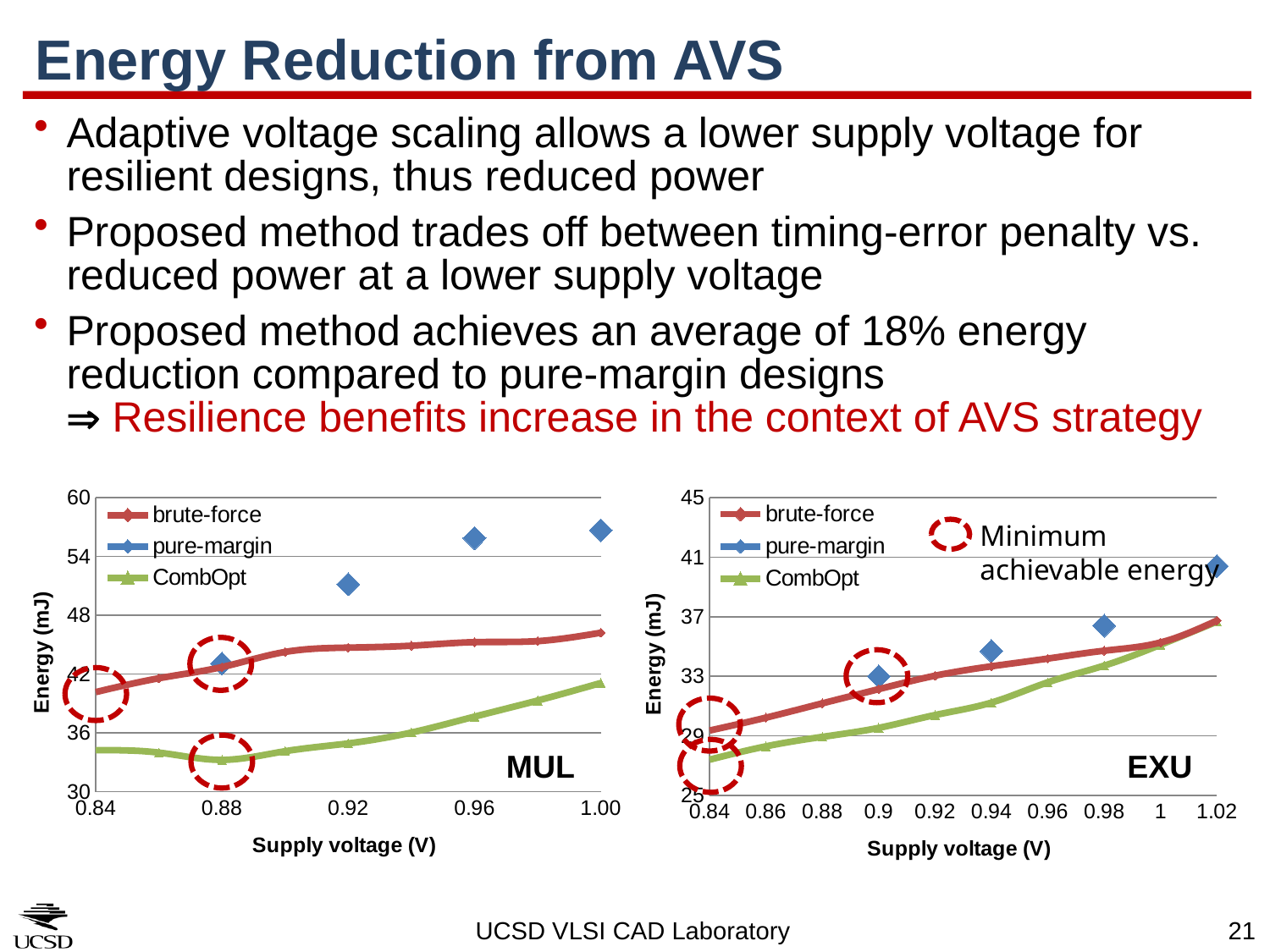
In the EXU chart, does the CombOpt energy rise or fall as supply voltage increases? rise In the EXU chart, is the CombOpt value at 0.84 V greater or less than 29? less What kind of chart is the EXU chart? line chart In the MUL chart, how many series does the legend list? 3 In the MUL chart, is the pure-margin value at 1.00 V greater or less than 54? greater What is the y-axis title of the MUL chart? Energy (mJ) In the EXU chart, is the CombOpt value at 0.94 V greater or less than 33? less In the MUL chart, does the brute-force energy rise or fall as supply voltage increases? rise In the EXU chart, at 0.98 V, which series has the higher energy: pure-margin or CombOpt? pure-margin In the MUL chart, at 1.00 V, which series has the higher energy: pure-margin or brute-force? pure-margin